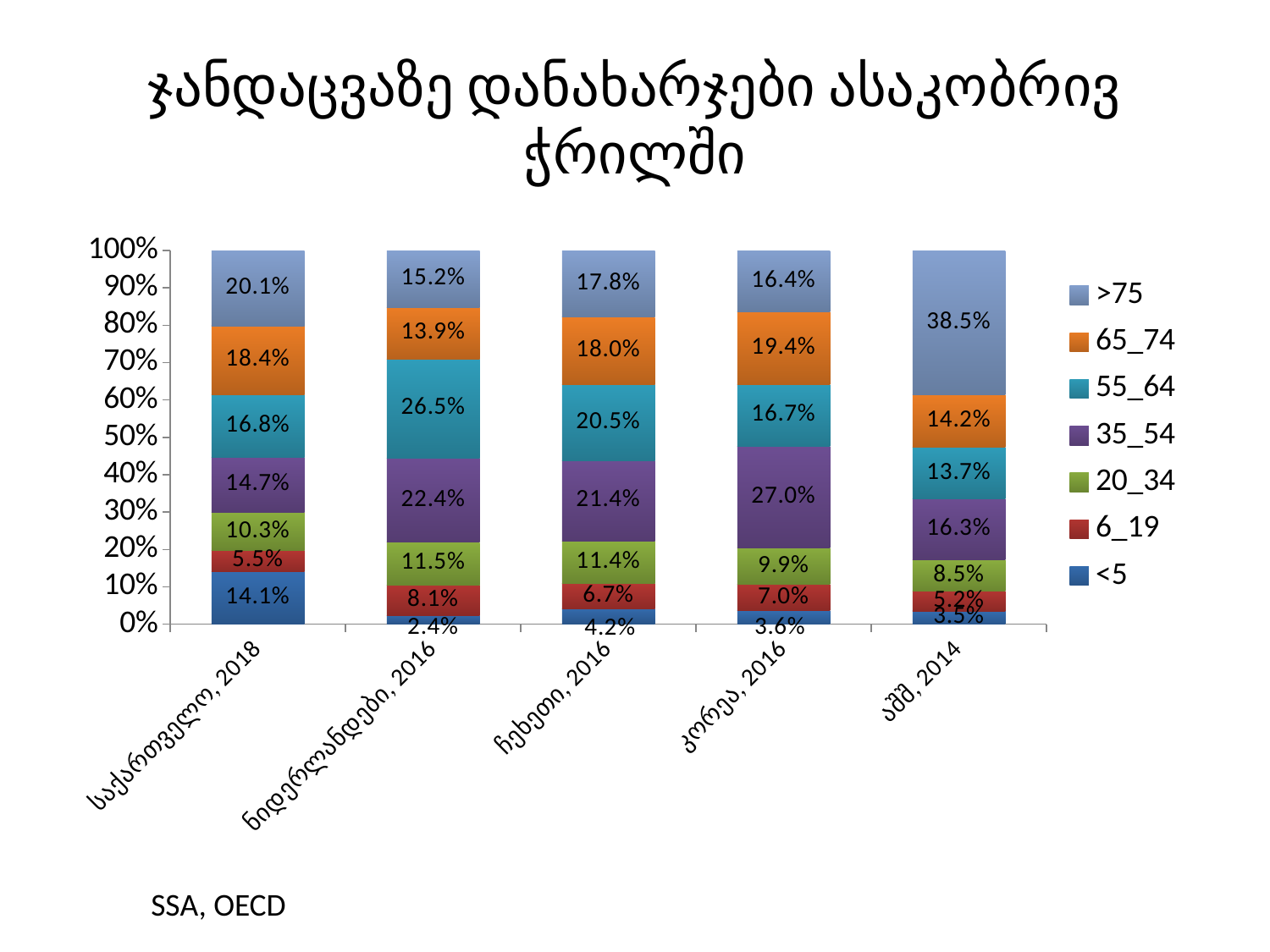
Which country has the highest >75 share? აშშ, 2014 What is the value of the 35_54 segment for კორეა, 2016? 27.0% What is the value of the 55_64 segment for ნიდერლანდები, 2016? 26.5% Which is larger: the 20_34 value for ჩეხეთი, 2016 or for აშშ, 2014? ჩეხეთი, 2016 What is the value of the <5 segment for საქართველო, 2018? 14.1% How many series does the legend list? 7 What is the source noted at the bottom of the slide? SSA, OECD How many bars (countries) are shown on the chart? 5 What is the difference between the 65_74 values for კორეა, 2016 and ნიდერლანდები, 2016? 5.5% Which country has the lowest <5 share? ნიდერლანდები, 2016 What is the value of the >75 segment for აშშ, 2014? 38.5% What type of chart is shown on the slide? stacked bar chart